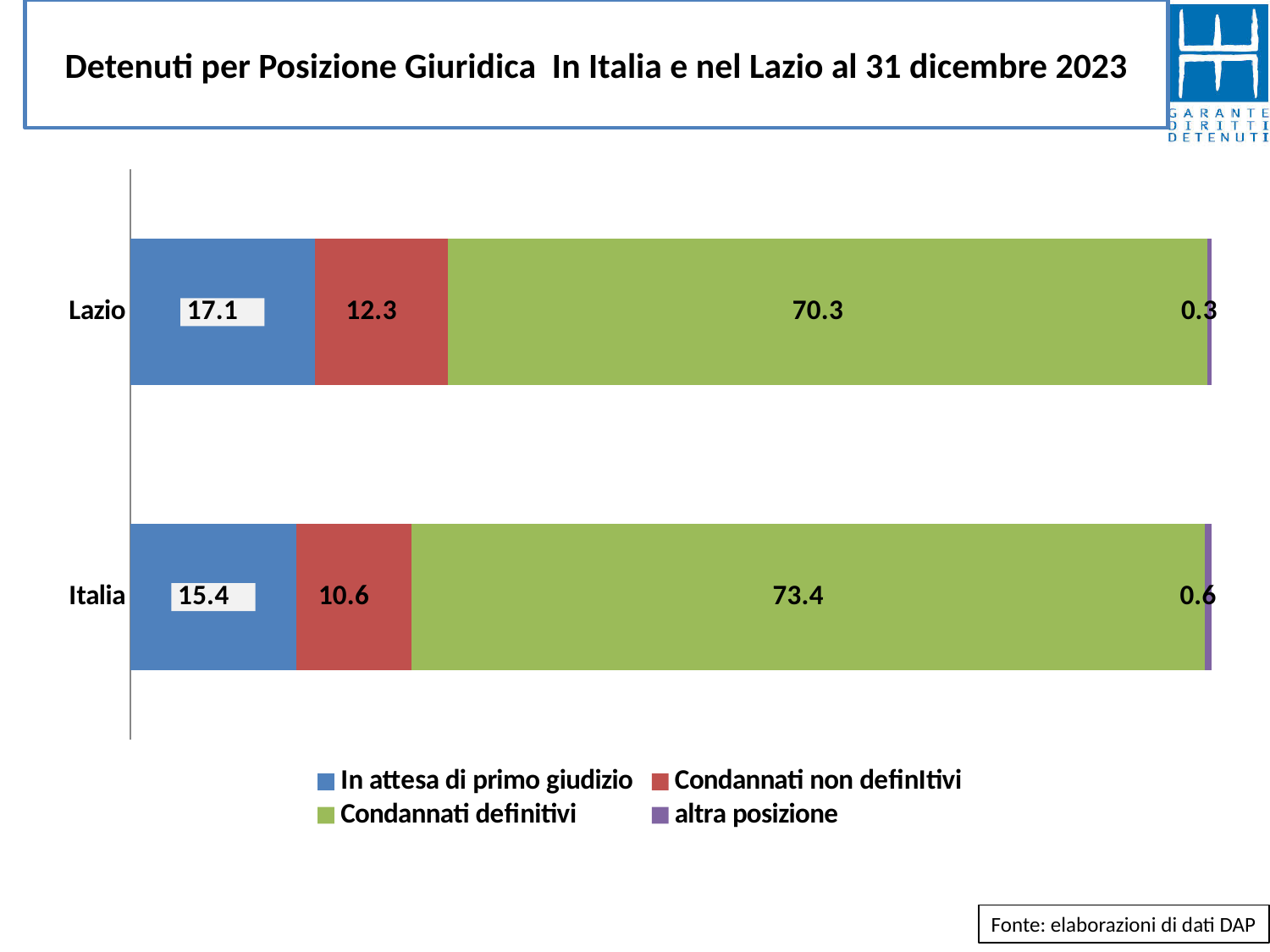
What is the value for 'altra posizione' for Italia? 0.6 How many series does the legend list? 4 What is the value for 'Condannati definitivi' for Italia? 73.4 What is the total of the stacked bar for Lazio? 100.0 What is the value for 'In attesa di primo giudizio' for Lazio? 17.1 Which series has the largest value for Italia? Condannati definitivi How many categories (bars) does the chart show? 2 What is the value for 'Condannati non definitivi' for Lazio? 12.3 Which is larger, the 'In attesa di primo giudizio' value for Lazio or for Italia? Lazio Which series has the smallest value for Lazio? altra posizione What kind of chart is shown on the slide? Stacked bar chart What is the difference between the 'Condannati definitivi' values for Italia and Lazio? 3.1